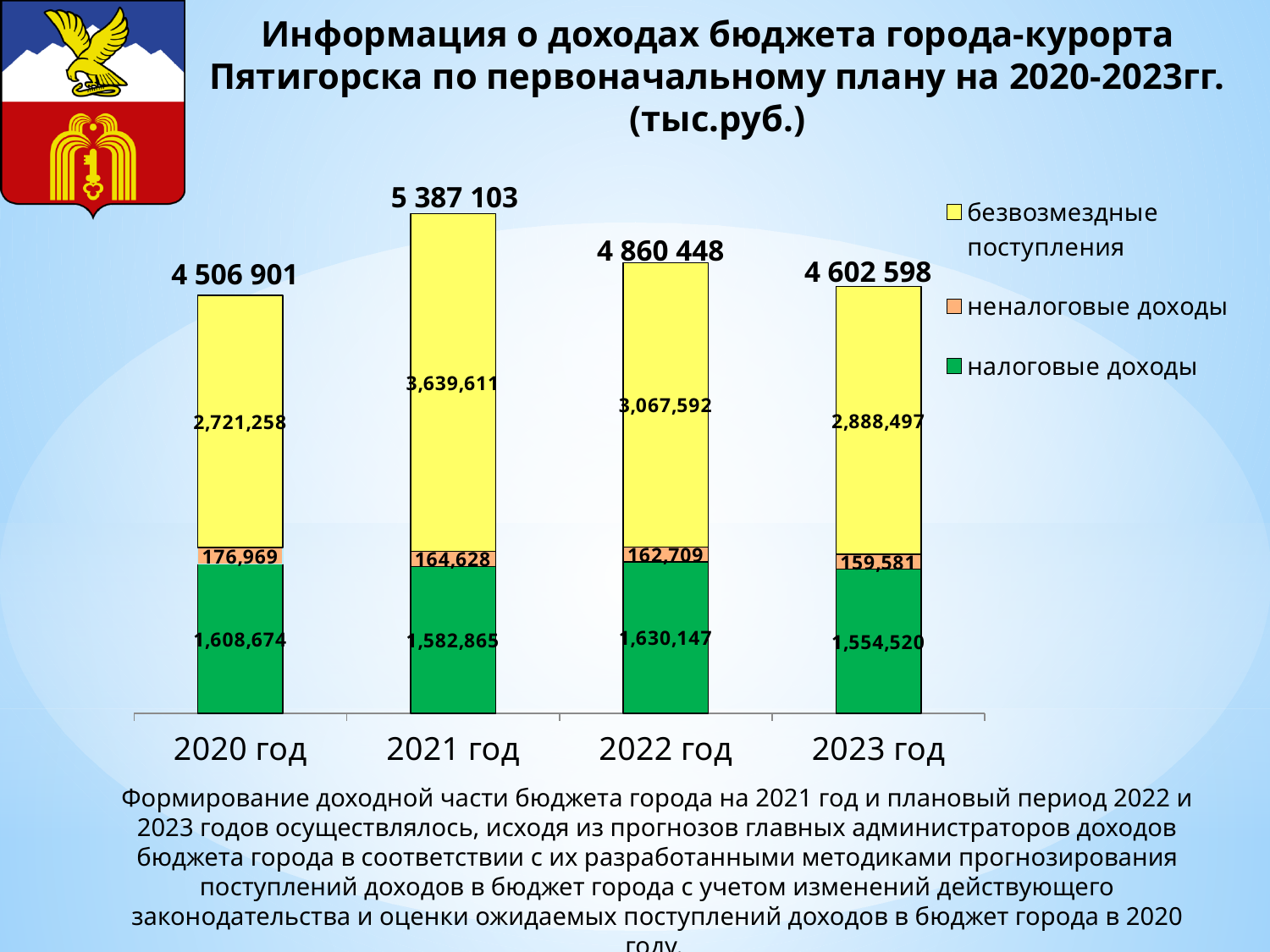
What is the value of налоговые доходы for 2020 год? 1,608,674 Which year has the lowest total bar? 2020 год What is the value of неналоговые доходы for 2022 год? 162,709 What kind of chart is shown on the slide? Stacked bar chart What is the difference between the total for 2021 год and the total for 2020 год? 880 202 What is the difference between безвозмездные поступления in 2022 год and in 2023 год? 179,095 What is the value of безвозмездные поступления for 2021 год? 3,639,611 Which year has the highest total bar? 2021 год How many years are shown on the x axis? 4 Do the values for неналоговые доходы rise or fall from 2020 год to 2023 год? Fall Which is larger: налоговые доходы in 2021 год or in 2023 год? 2021 год How many series does the legend list? 3